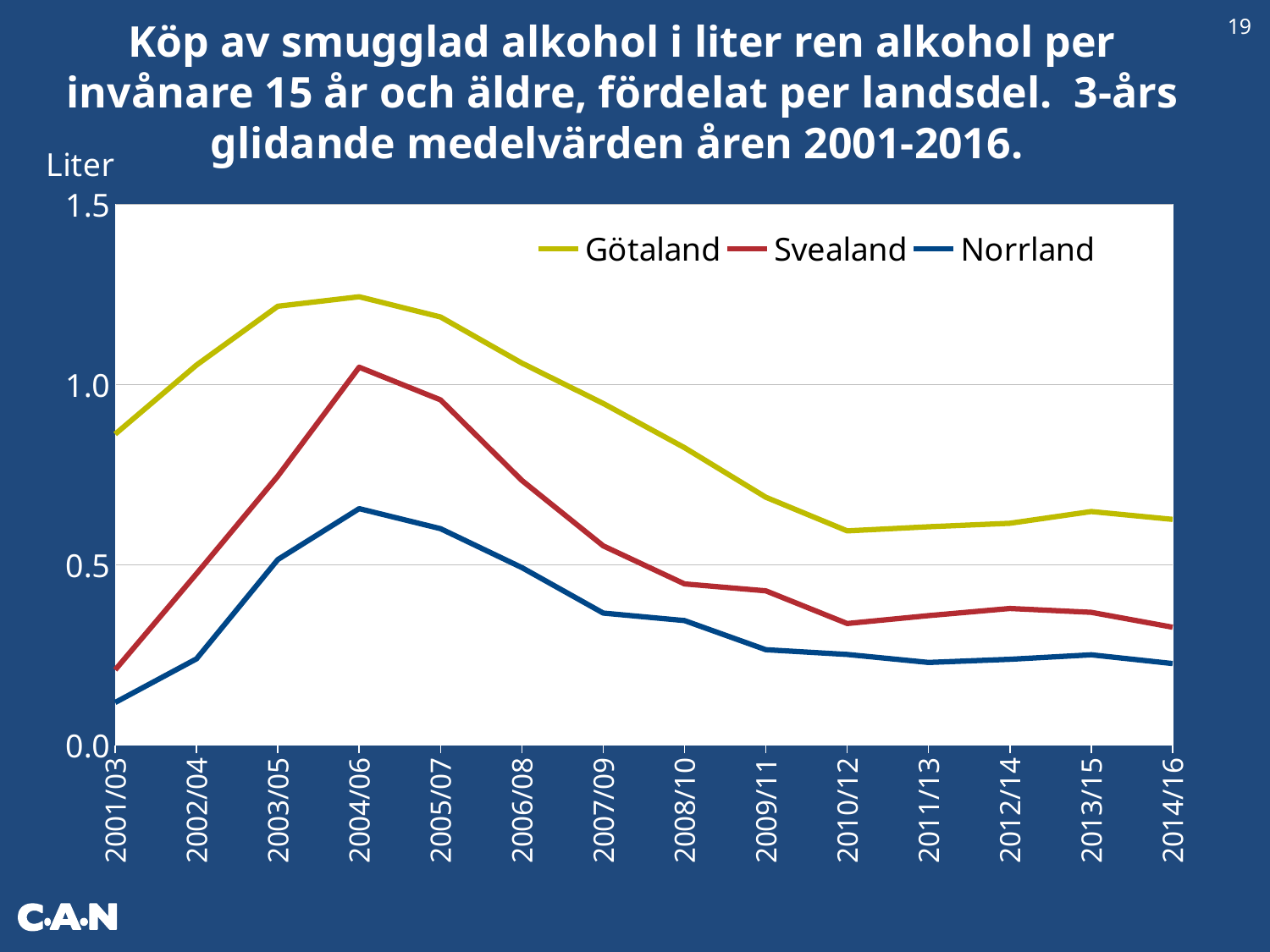
What is the label on the y axis? Liter What kind of chart is shown on the slide? line chart Which series has the highest values across the whole period? Götaland Is the value for Svealand in 2014/16 greater or less than 0.5? less Which series has the lowest values across the whole period? Norrland Do the Götaland values rise or fall from 2004/06 to 2010/12? fall How many periods are shown along the x axis? 14 How many series does the legend list? 3 In which period does the Götaland line reach its highest value? 2004/06 Is the value for Götaland in 2004/06 greater or less than 1.0? greater Is the value for Norrland in 2001/03 greater or less than 0.5? less In which period does the Svealand line reach its highest value? 2004/06